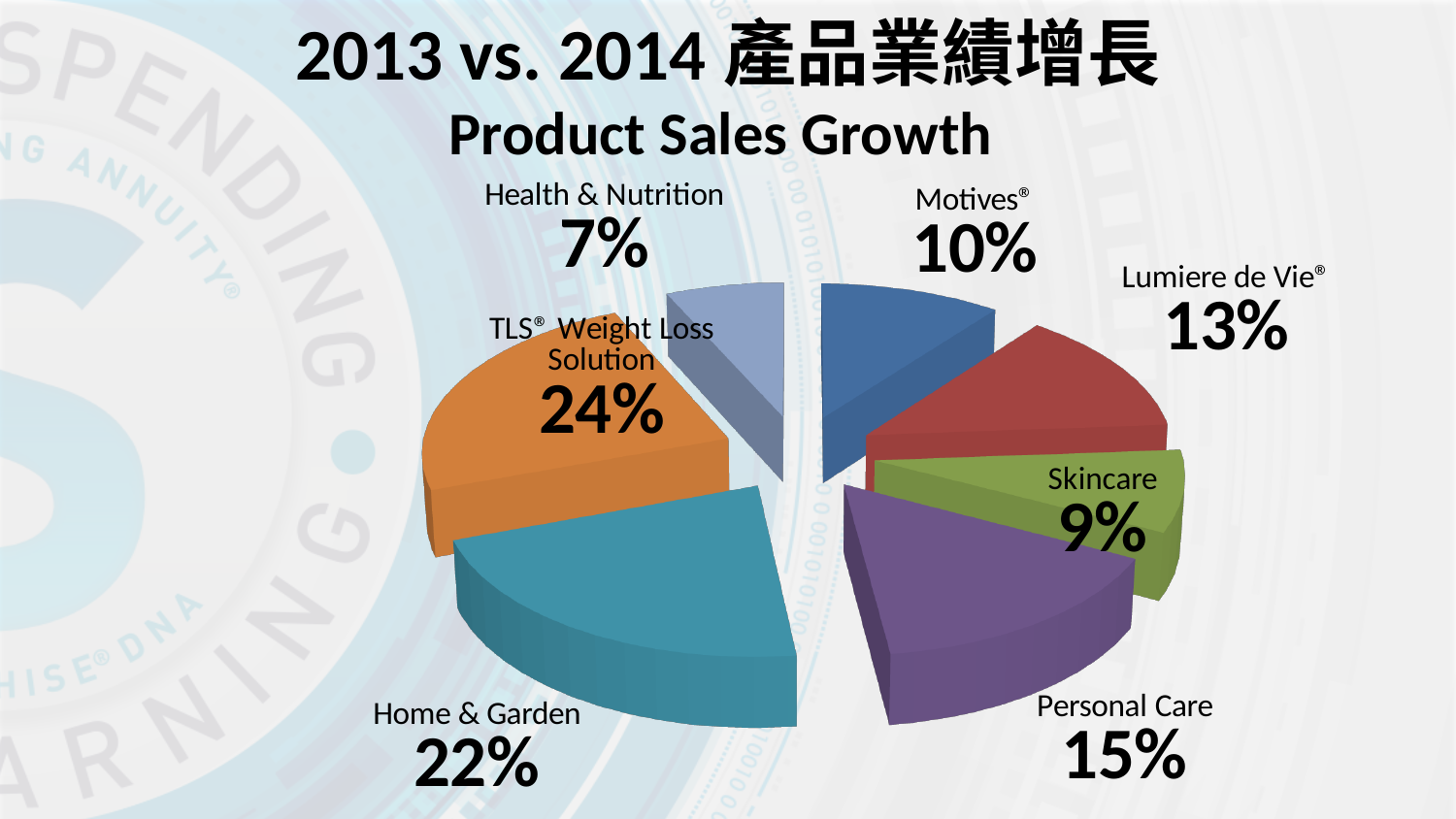
What percentage is shown for Home & Garden? 22% What percentage is shown for Lumiere de Vie? 13% What colour is the Personal Care slice? Purple Which category has the smallest share of the pie? Health & Nutrition What is the English title of the chart? Product Sales Growth What is the combined share of Home & Garden and TLS Weight Loss Solution? 46% Which is larger, the share for Lumiere de Vie or the share for Motives? Lumiere de Vie Which category has the largest share of the pie? TLS Weight Loss Solution What kind of chart is shown on the slide? Pie chart What is the difference between the Personal Care and Skincare percentages? 6% What percentage is shown for Motives? 10% How many categories are shown in the pie chart? 7